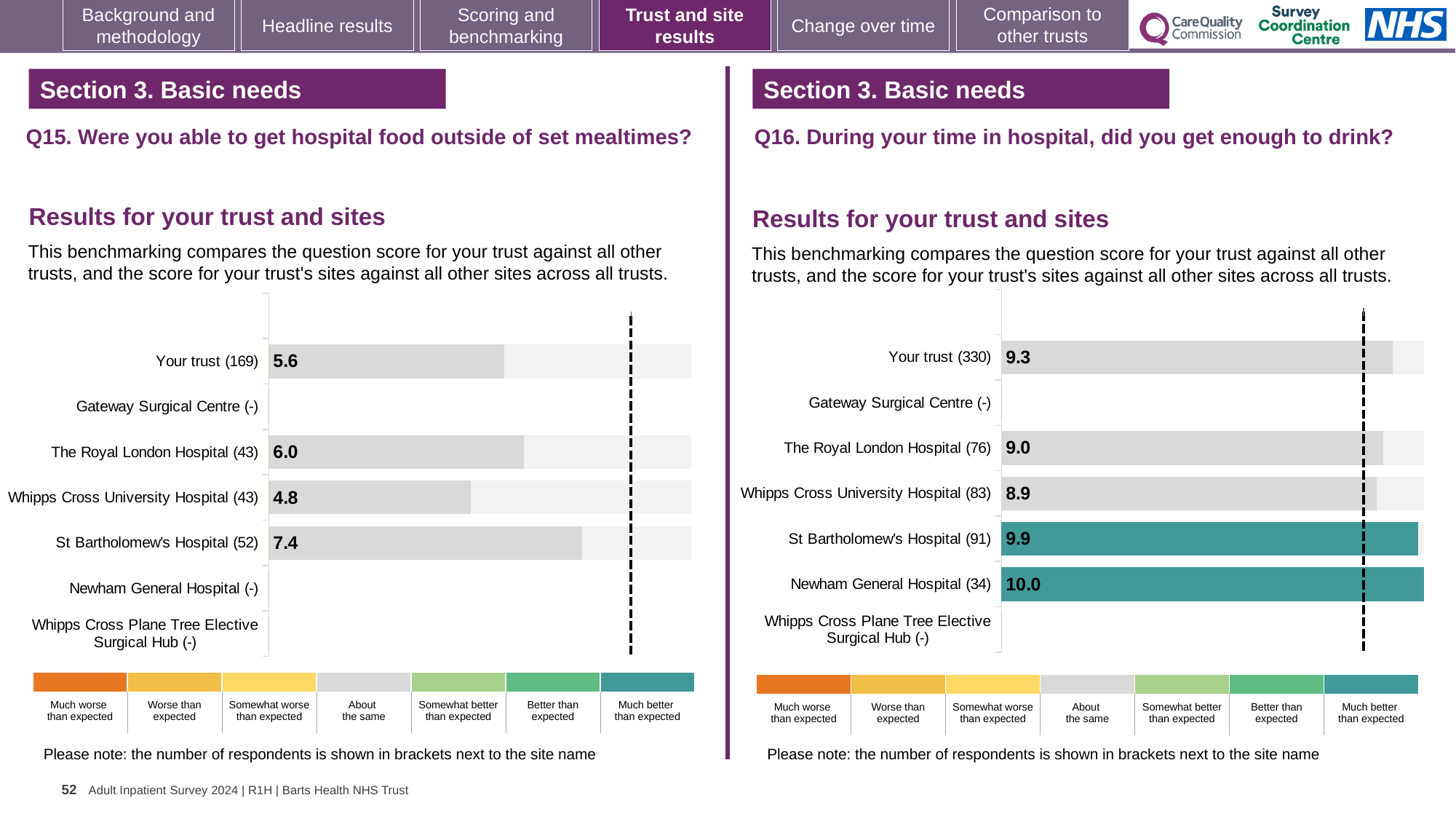
On the Q15 chart (left), what is the score for Your trust? 5.6 On the Q15 chart (left), what is the difference between the scores for St Bartholomew's Hospital and Whipps Cross University Hospital? 2.6 On the Q15 chart (left), which is higher: the score for The Royal London Hospital or for Your trust? The Royal London Hospital On the Q15 chart (left), which site has the lowest score? Whipps Cross University Hospital On the Q16 chart (right), what is the score for Newham General Hospital? 10.0 How many site/trust rows are listed on the Q15 chart (left), including those with no data? 7 On the Q15 chart (left), what is the score for St Bartholomew's Hospital? 7.4 On the Q16 chart (right), what is the score for Whipps Cross University Hospital? 8.9 On the Q16 chart (right), what is the difference between the scores for Your trust and The Royal London Hospital? 0.3 On the Q16 chart (right), which site has the highest score? Newham General Hospital What kind of chart is used on the Q16 chart (right)? Bar chart On the Q16 chart (right), how many respondents are shown in brackets for St Bartholomew's Hospital? 91